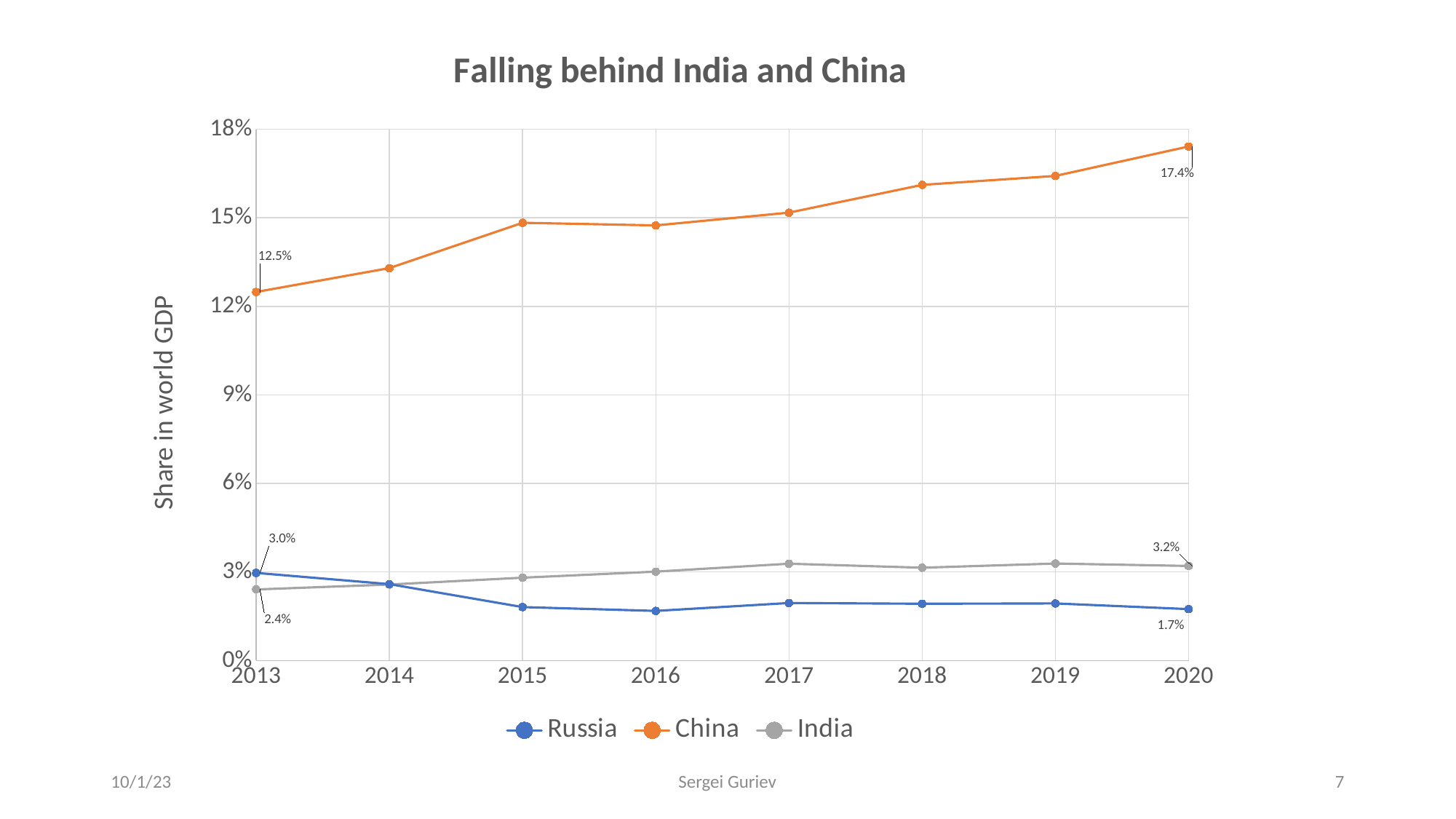
In 2013, which was larger: Russia's share or India's share? Russia What is Russia's share in world GDP in 2013? 3.0% What is China's share in world GDP in 2020? 17.4% Which series has the highest share in world GDP in 2020? China What kind of chart is shown on the slide? Line chart Which series has the lowest share in world GDP in 2020? Russia What is China's share in world GDP in 2013? 12.5% What is Russia's share in world GDP in 2020? 1.7% How many series does the legend list? 3 What is India's share in world GDP in 2020? 3.2% By how many percentage points did China's share in world GDP change from 2013 to 2020? 4.9 percentage points